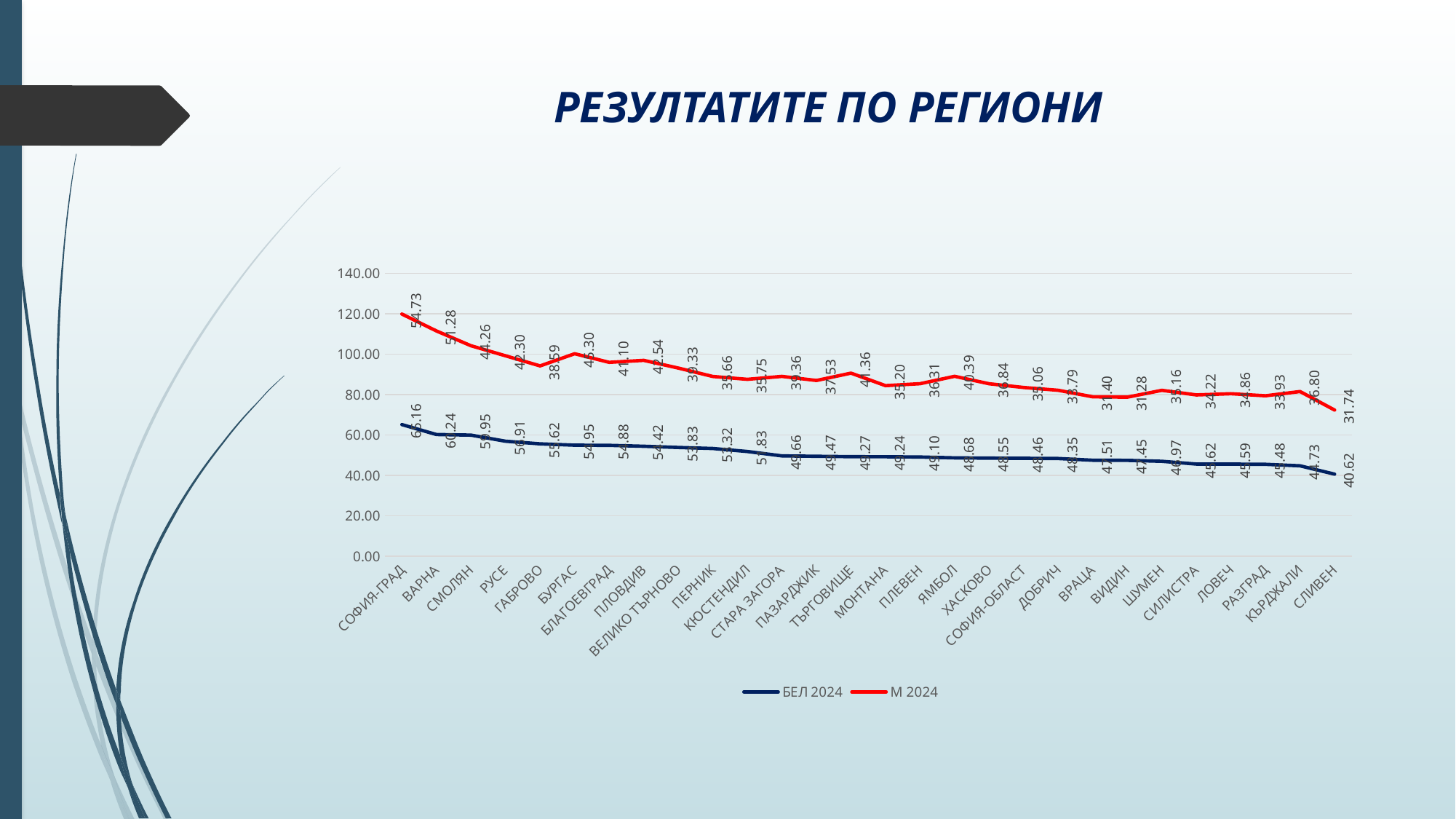
Which region has the lowest БЕЛ 2024 value? СЛИВЕН What kind of chart is shown on the slide? line chart What is the difference between the БЕЛ 2024 and М 2024 values for СОФИЯ-ГРАД? 10.43 How many series does the legend list? 2 What is the БЕЛ 2024 value for СЛИВЕН? 40.62 What is the БЕЛ 2024 value for СОФИЯ-ГРАД? 65.16 What is the М 2024 value for ВАРНА? 51.28 How many regions are shown on the x axis? 28 Which region has the highest БЕЛ 2024 value? СОФИЯ-ГРАД Do the БЕЛ 2024 values generally rise or fall from left to right along the x axis? fall Which is larger, the БЕЛ 2024 value for ВАРНА or for СМОЛЯН? ВАРНА What is the М 2024 value for БУРГАС? 45.30